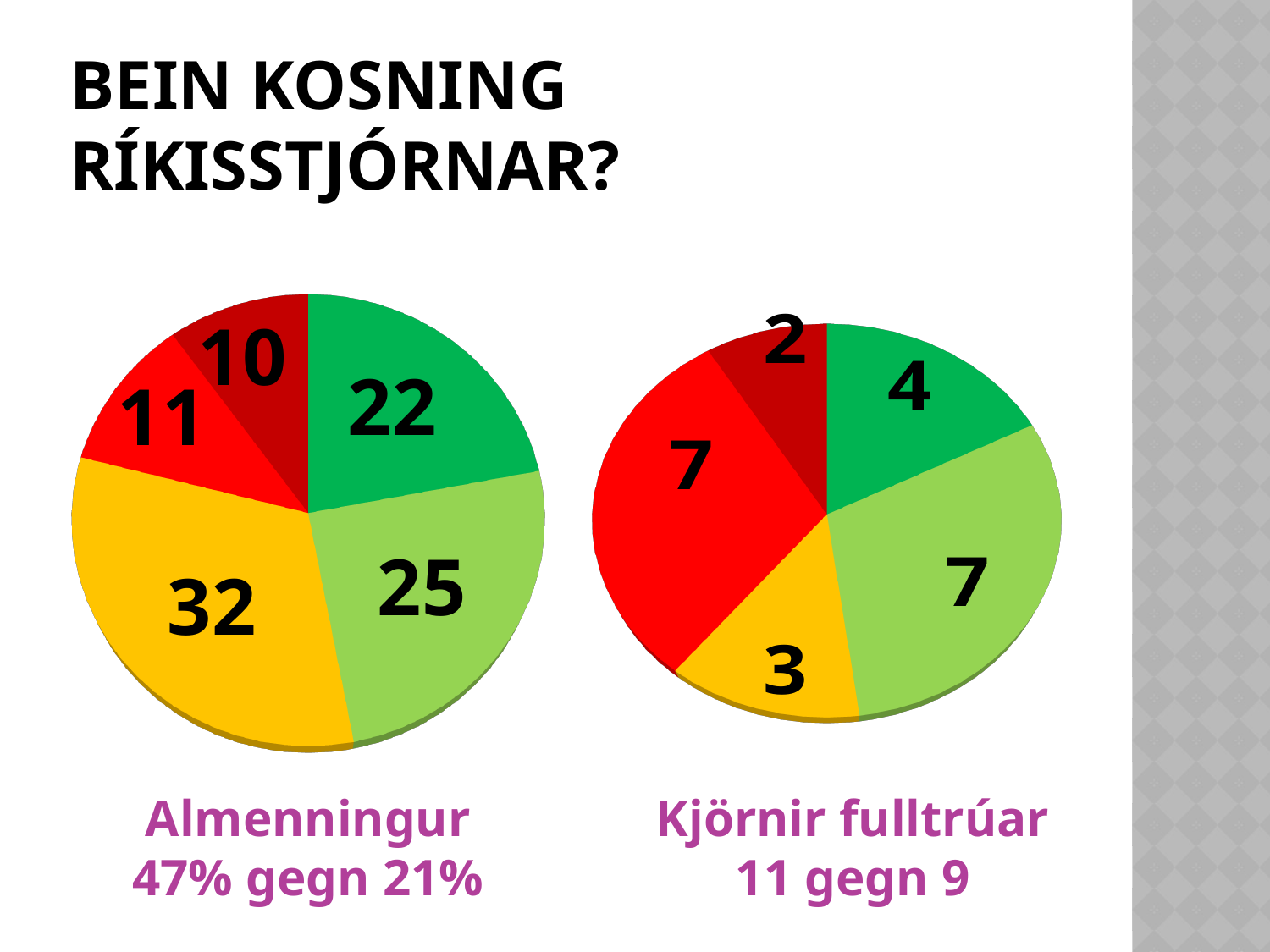
How many slices does the right pie chart (Kjörnir fulltrúar) have? 5 In the right pie chart (Kjörnir fulltrúar), what is the value of the smallest slice? 2 What kind of chart is the left chart labelled "Almenningur"? pie chart What is the total of all slice values in the left pie chart (Almenningur)? 100 In the left pie chart (Almenningur), what share of the total does the yellow slice represent? 32% In the left pie chart (Almenningur), what is the difference between the yellow slice and the light green slice? 7 How many slices does the left pie chart (Almenningur) have? 5 In the left pie chart (Almenningur), what is the value of the largest slice? 32 In the left pie chart (Almenningur), what value is shown on the yellow slice? 32 In the right pie chart (Kjörnir fulltrúar), what value is shown on the dark green slice? 4 In the left pie chart (Almenningur), which slice is larger, the dark green one or the bright red one? the dark green one What label appears beneath the left pie chart? Almenningur 47% gegn 21%